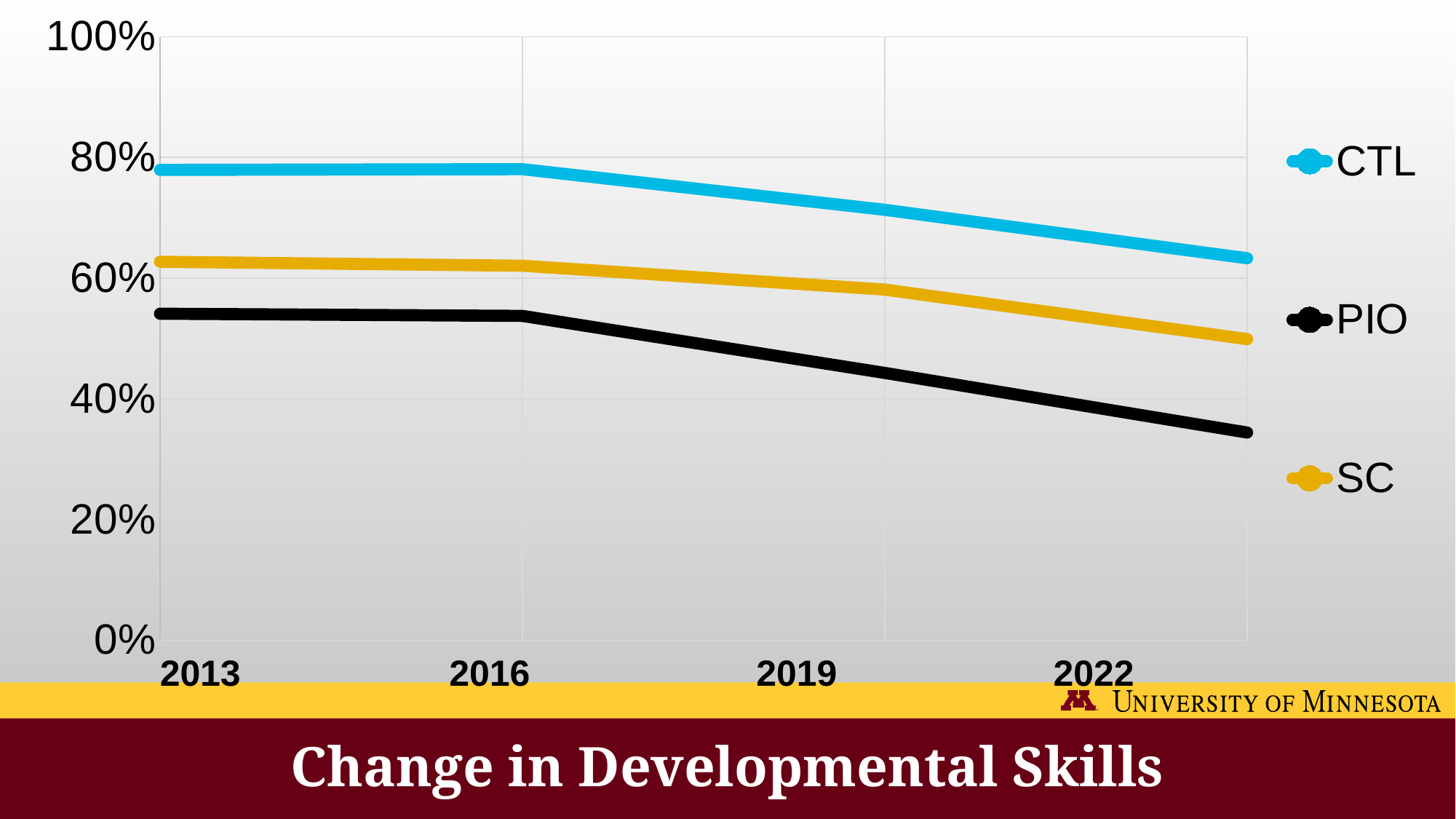
Which series has the highest value in 2022? CTL Do the values for PIO rise or fall from 2013 to 2022? fall Is the value for PIO in 2013 greater or less than 40%? greater Which is larger in 2019, the value for SC or the value for PIO? SC Which series has the lowest value in 2013? PIO Is the value for PIO in 2022 greater or less than 40%? less What is the title of the chart? Change in Developmental Skills What colour is the line for SC? gold How many years are shown on the x axis? 4 Is the value for CTL in 2013 greater or less than 60%? greater What kind of chart is shown on the slide? line chart How many series does the legend list? 3